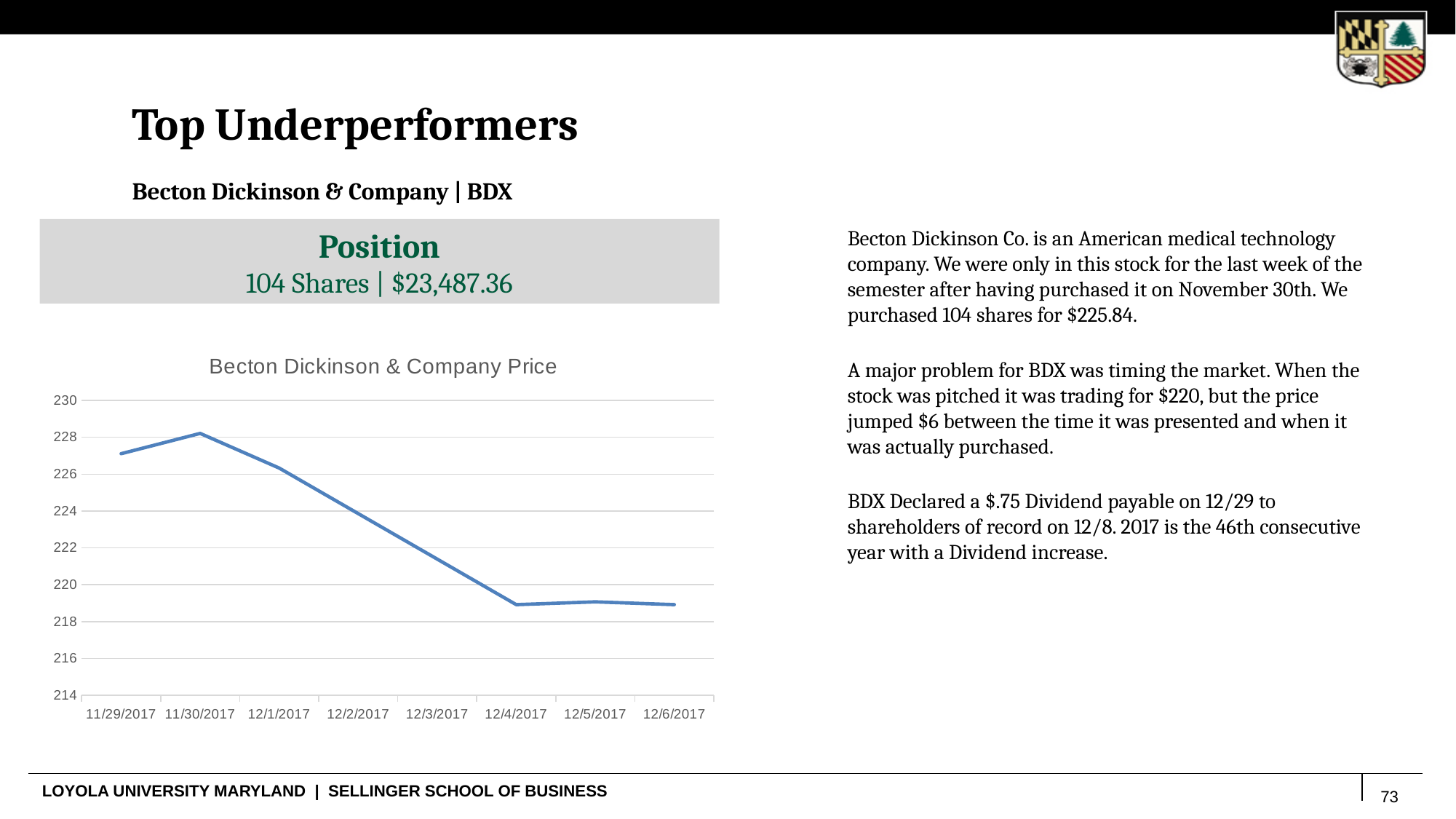
What kind of chart is shown on the slide? line chart On which date does the price reach its highest point? 11/30/2017 What is the lowest value shown on the y axis of the chart? 214 Is the price on 11/29/2017 greater or less than 226? greater Overall, does the price rise or fall from 11/29/2017 to 12/6/2017? fall Which date has the higher price, 11/30/2017 or 12/1/2017? 11/30/2017 How many dates are plotted on the x axis of the chart? 8 What is the title of the chart? Becton Dickinson & Company Price Which date has the higher price, 11/29/2017 or 12/6/2017? 11/29/2017 Is the price on 12/4/2017 greater or less than 220? less